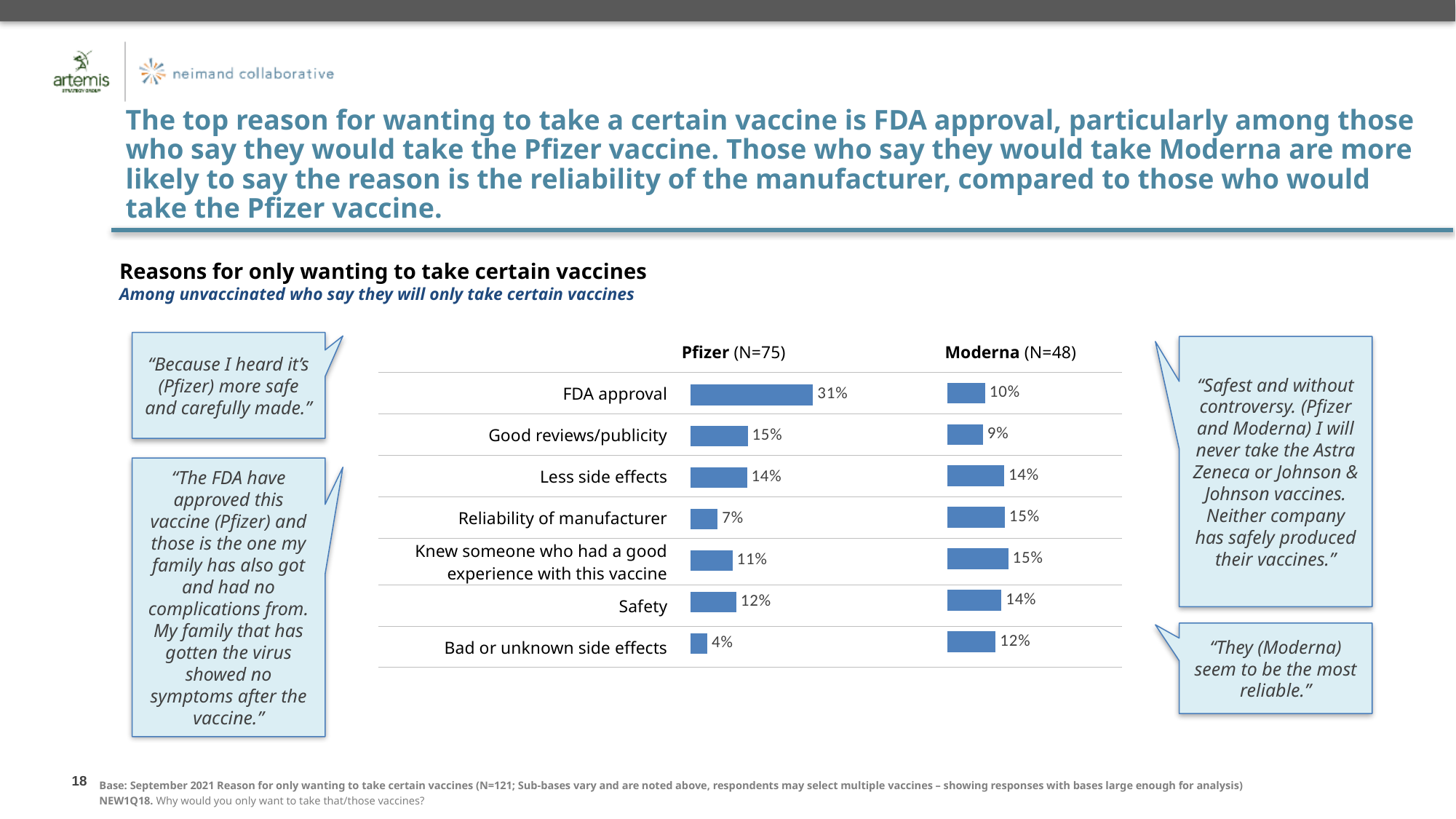
What is the difference between the Pfizer and Moderna values for FDA approval? 21 percentage points How many reasons are listed in the chart? 7 Which reason has the lowest value among Pfizer respondents? Bad or unknown side effects Which reason has the highest value among Pfizer respondents? FDA approval Which is larger for reliability of manufacturer: the Pfizer value or the Moderna value? Moderna What percentage of Moderna respondents cite reliability of manufacturer as a reason? 15% What is the Pfizer value for bad or unknown side effects? 4% What percentage of Pfizer respondents cite FDA approval as a reason? 31% Which reason has the lowest value among Moderna respondents? Good reviews/publicity What is the sample size (N) for the Moderna group? 48 How many vaccine groups are shown in the chart? 2 What type of chart is used to show the reasons for only wanting to take certain vaccines? Bar chart